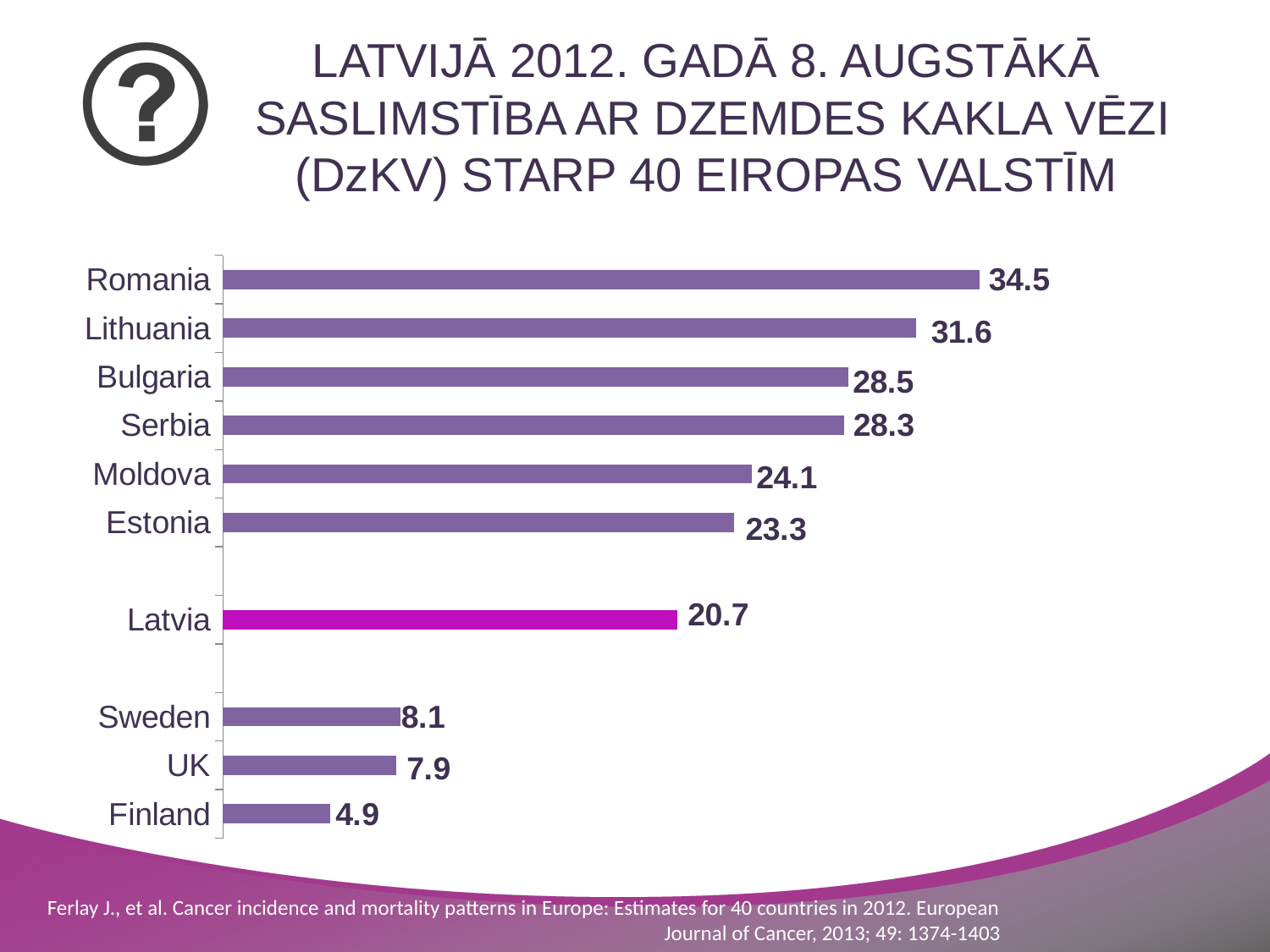
Which is larger, the value for Moldova or the value for Estonia? Moldova What is the value for Romania? 34.5 Which country's bar is shown in a different colour (magenta) from the others? Latvia How many countries are shown in the chart? 10 Which country has the highest value? Romania Which is larger, the value for Lithuania or the value for Bulgaria? Lithuania What is the difference between the values for Romania and Latvia? 13.8 What kind of chart is shown on the slide? Bar chart What is the value for Estonia? 23.3 Which country has the lowest value? Finland What is the difference between the values for Sweden and UK? 0.2 What is the value for Latvia? 20.7